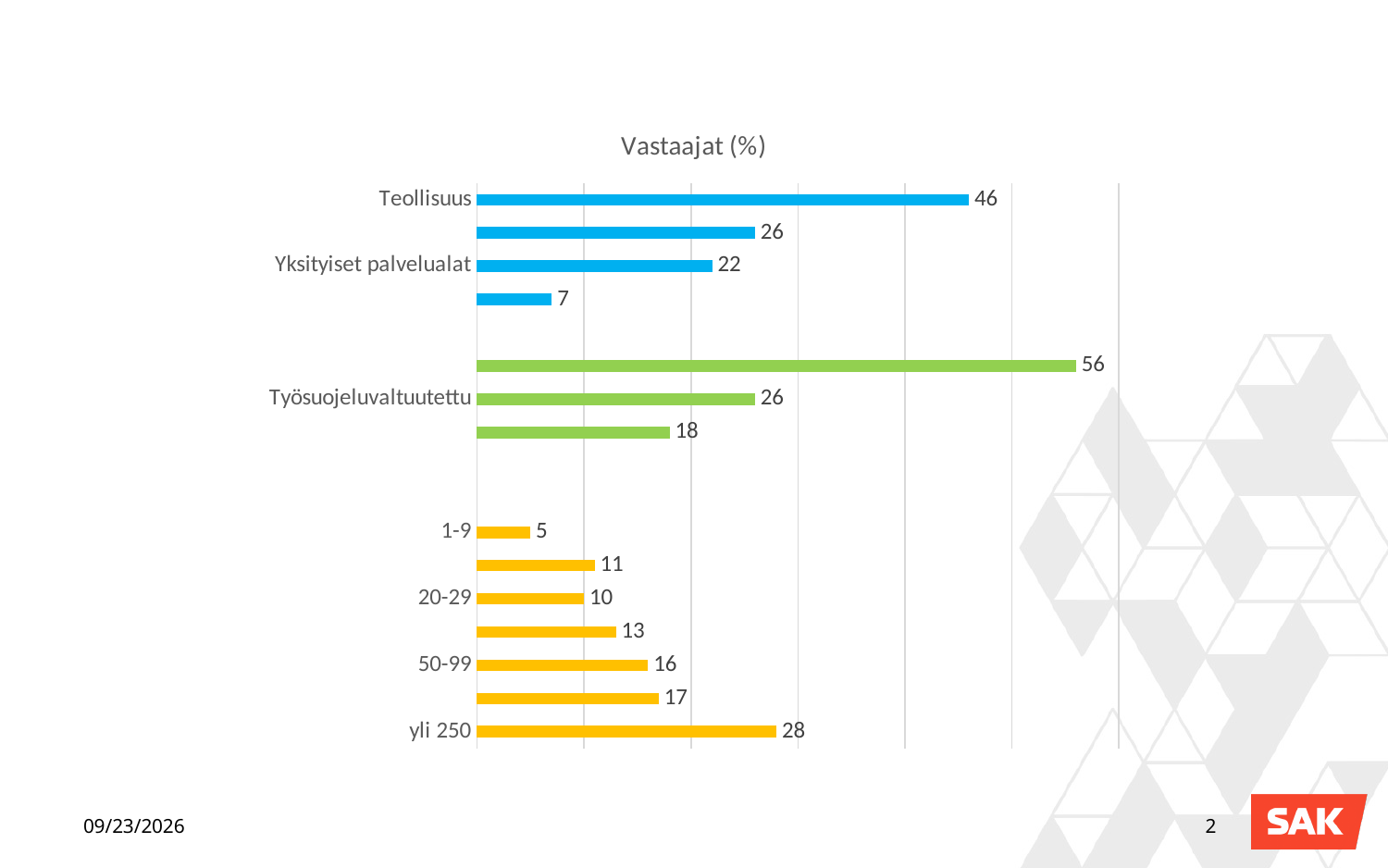
What is the value for 20-29? 10 What kind of chart is shown on the slide? Bar chart What is the highest value shown on the chart? 56 What is the difference between the values for Teollisuus and Yksityiset palvelualat? 24 Which has a larger value, yli 250 or 50-99? yli 250 What is the value for Työsuojeluvaltuutettu? 26 What is the value for Teollisuus? 46 What is the value for yli 250? 28 What is the title of the chart? Vastaajat (%) What is the value for 50-99? 16 What is the value for the 1-9 category? 5 What is the value for Yksityiset palvelualat? 22